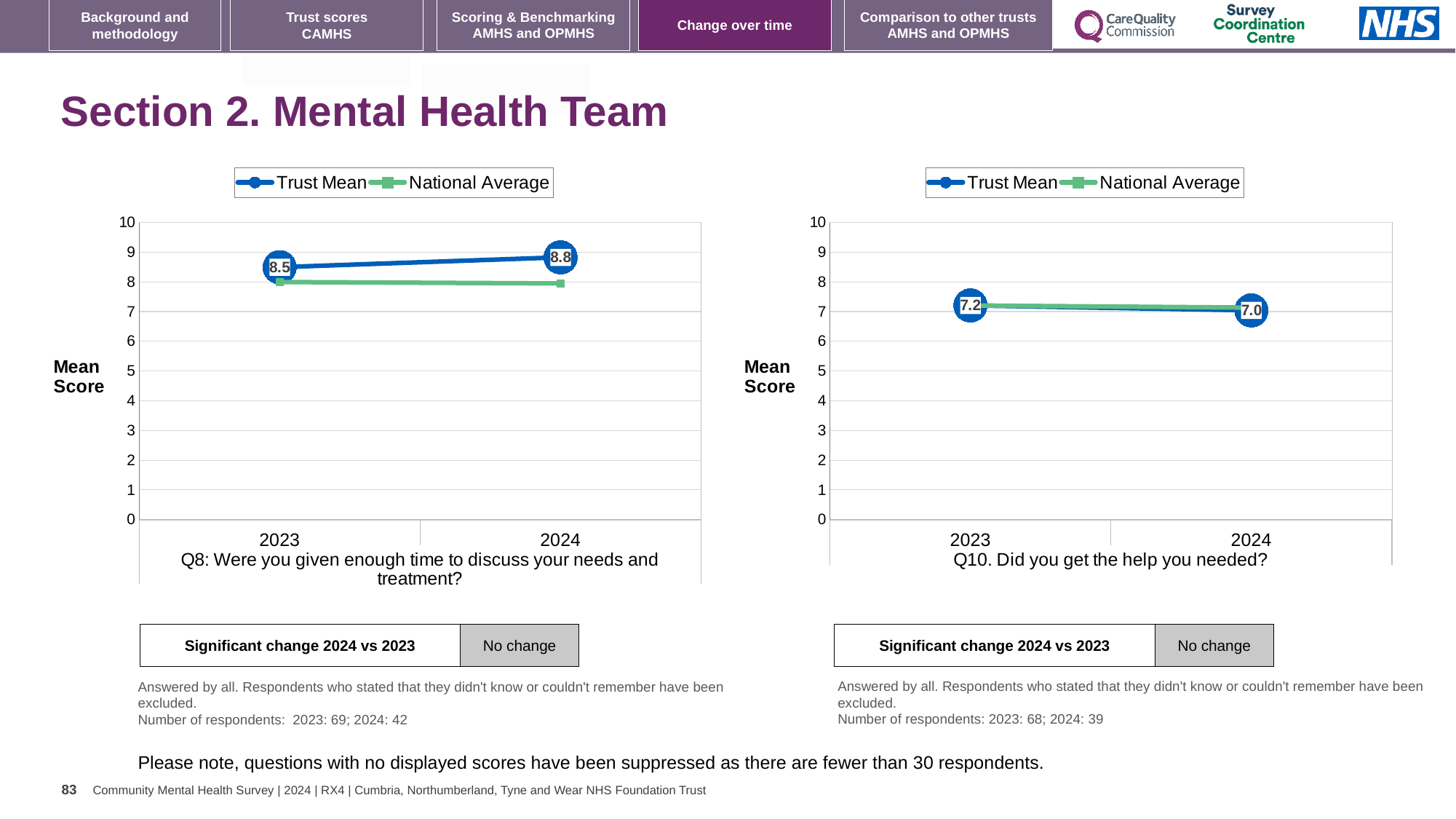
How many series does the legend of the Q10 chart on the right list? 2 In the Q8 chart on the left, what is the Trust Mean score for 2024? 8.8 In the Q10 chart on the right, does the Trust Mean rise or fall from 2023 to 2024? fall In the Q10 chart on the right, what is the difference between the Trust Mean for 2023 and 2024? 0.2 In the Q8 chart on the left, is the Trust Mean or the National Average higher in 2024? Trust Mean In the Q8 chart on the left, what is the Trust Mean score for 2023? 8.5 In the Q10 chart on the right, what is the Trust Mean score for 2024? 7.0 In the Q8 chart on the left, is the National Average for 2024 greater or less than 9? less In the Q10 chart on the right, what is the Trust Mean score for 2023? 7.2 What kind of chart is the Q8 chart on the left? line chart In the Q8 chart on the left, does the Trust Mean rise or fall from 2023 to 2024? rise In the Q8 chart on the left, by how much did the Trust Mean change from 2023 to 2024? 0.3